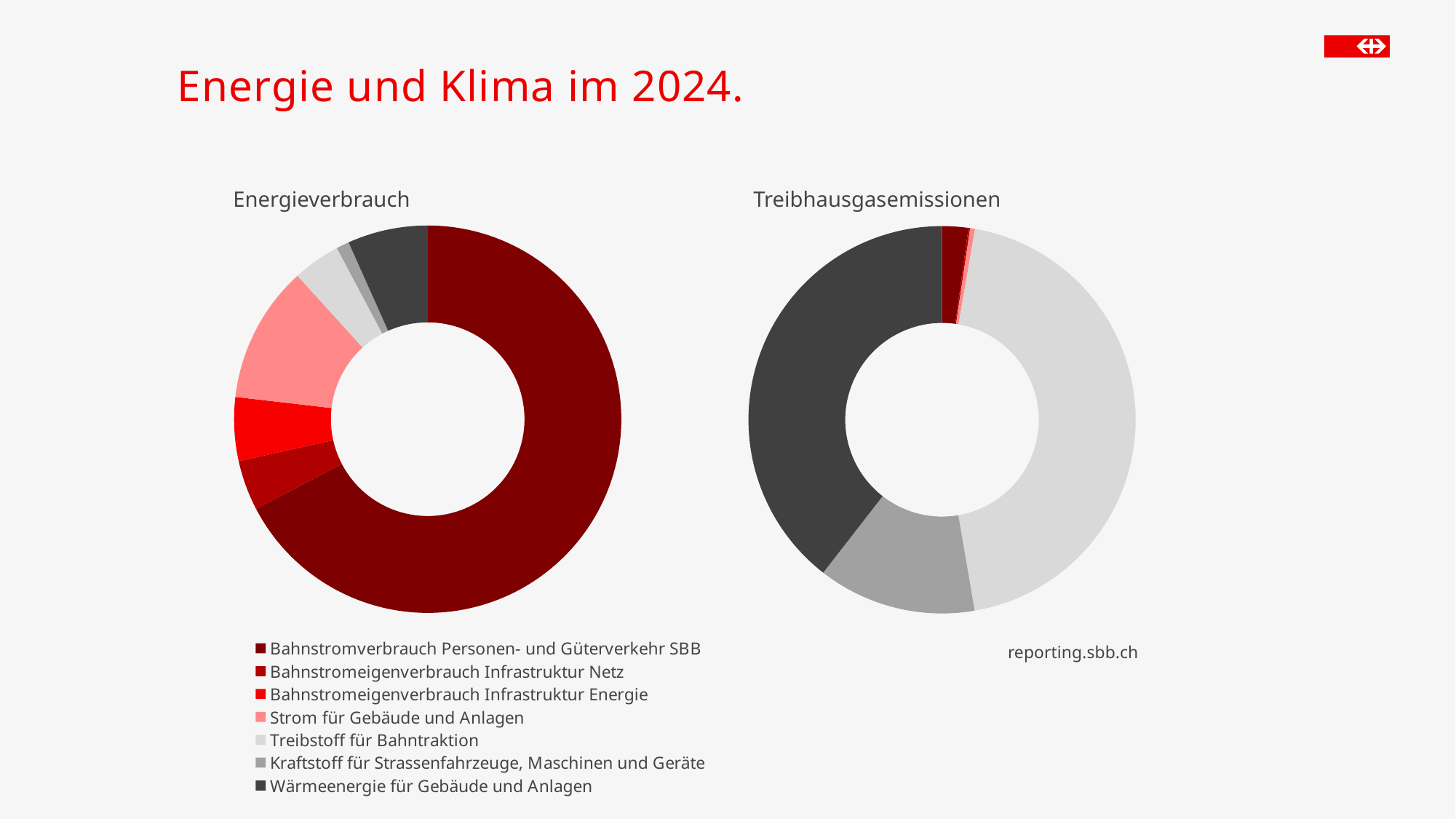
In the Energieverbrauch chart, which is larger: Strom für Gebäude und Anlagen or Treibstoff für Bahntraktion? Strom für Gebäude und Anlagen What is the title of the slide? Energie und Klima im 2024. In the Treibhausgasemissionen chart, which is larger: Wärmeenergie für Gebäude und Anlagen or Kraftstoff für Strassenfahrzeuge, Maschinen und Geräte? Wärmeenergie für Gebäude und Anlagen In the Energieverbrauch chart, which category has the largest share? Bahnstromverbrauch Personen- und Güterverkehr SBB In the Treibhausgasemissionen chart, which category has the largest share? Treibstoff für Bahntraktion What kind of chart is the Energieverbrauch chart? Pie chart (donut) In the Energieverbrauch chart, which is larger: Bahnstromeigenverbrauch Infrastruktur Energie or Wärmeenergie für Gebäude und Anlagen? Wärmeenergie für Gebäude und Anlagen What is the title of the chart on the right? Treibhausgasemissionen In the Energieverbrauch chart, which category has the smallest share? Kraftstoff für Strassenfahrzeuge, Maschinen und Geräte How many categories does the legend list for the charts? 7